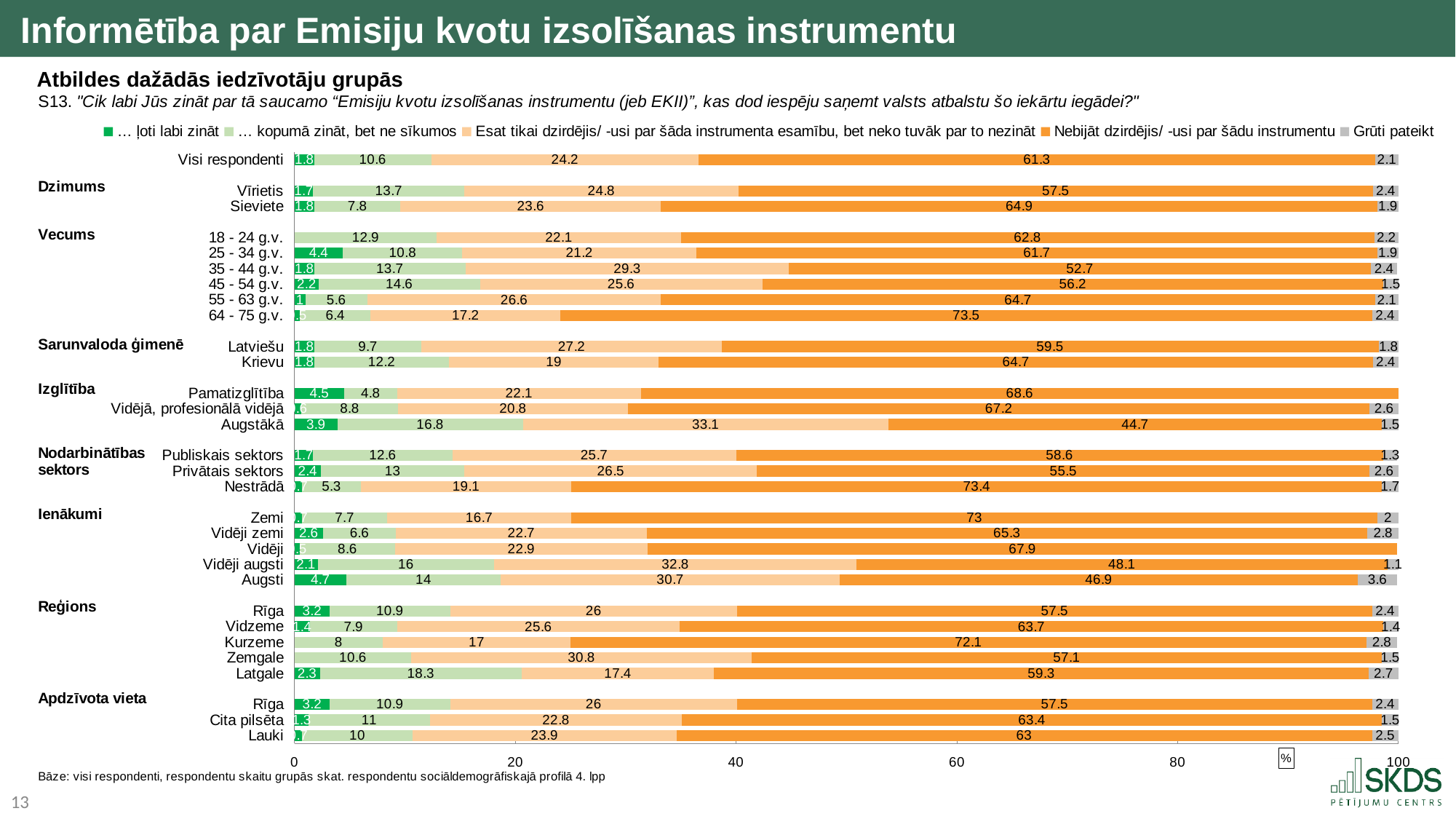
What is the value of "Esat tikai dzirdējis/ -usi par šāda instrumenta esamību, bet neko tuvāk par to nezināt" for Augstākā? 33.1 What is the value of "… kopumā zināt, bet ne sīkumos" for Latgale? 18.3 What kind of chart is shown on the slide? Stacked bar chart Is the "Nebijāt dzirdējis/ -usi par šādu instrumentu" value for Lauki greater or less than 60? greater What is the difference between the "Nebijāt dzirdējis/ -usi par šādu instrumentu" values for Sieviete and Vīrietis? 7.4 Which has a larger "Nebijāt dzirdējis/ -usi par šādu instrumentu" value, Rīga or Vidzeme? Vidzeme How many age groups (Vecums) are shown in the chart? 6 How many series does the legend list? 5 Which group has the lowest value for "Nebijāt dzirdējis/ -usi par šādu instrumentu"? Augstākā What is the value of "Grūti pateikt" for Augsti? 3.6 What is the value of "Nebijāt dzirdējis/ -usi par šādu instrumentu" for Visi respondenti? 61.3 Which group has the highest value for "… kopumā zināt, bet ne sīkumos"? Latgale